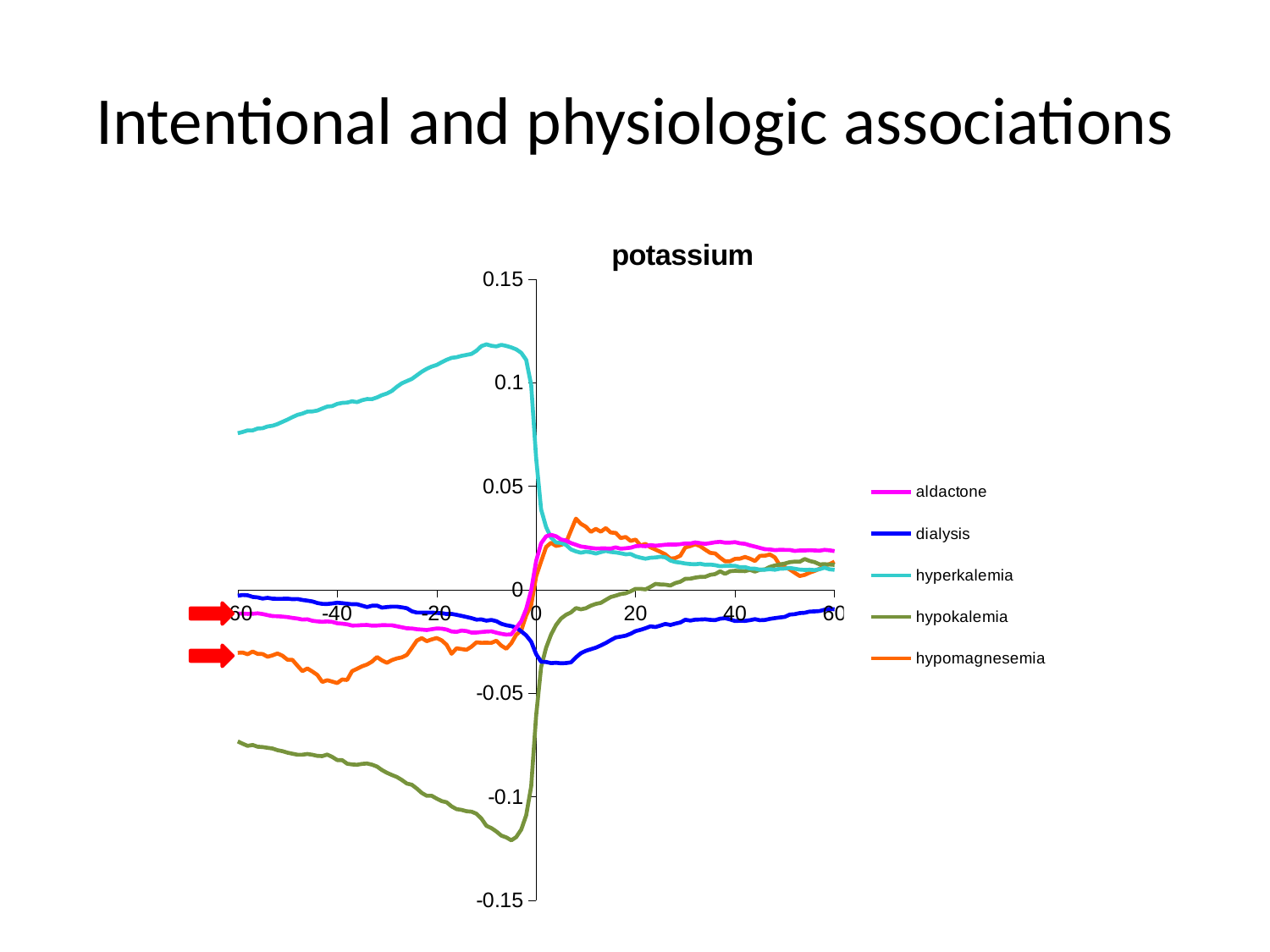
What colour is the hyperkalemia line in the chart? cyan Does the hyperkalemia series rise or fall as x goes from -60 to -10? rise Which series has the lowest value at x = -60? hypokalemia Is the value of the dialysis series at x = 0 greater or less than 0? less Does the hypokalemia series rise or fall as x goes from -60 to -10? fall How many series does the legend of the potassium chart list? 5 Is the value of the hyperkalemia series at x = -20 greater or less than 0.1? greater At x = 40, which series has the larger value, aldactone or dialysis? aldactone What is the title of the chart? potassium Which series has the highest value at x = -60? hyperkalemia What kind of chart is shown on the slide? line chart Is the value of the hypokalemia series at x = -10 greater or less than -0.1? less